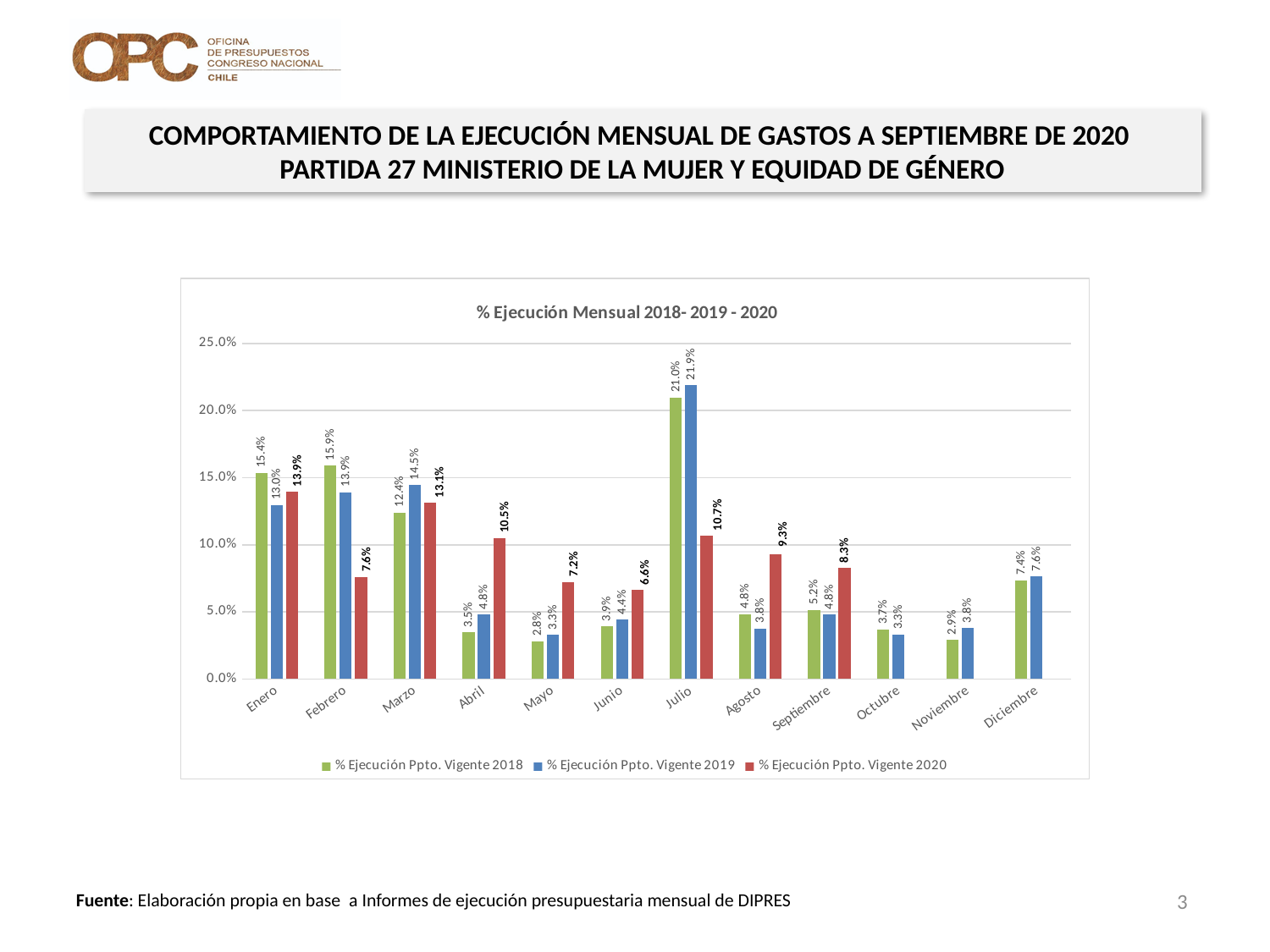
How many months are shown on the x axis? 12 What is the difference between the 2019 and 2018 values in Julio? 0.9% What is the value for % Ejecución Ppto. Vigente 2020 in Abril? 10.5% Which month has the highest value for % Ejecución Ppto. Vigente 2020? Enero What kind of chart is shown on the slide? Bar chart How many series does the legend list? 3 Is the value for % Ejecución Ppto. Vigente 2019 in Marzo greater or less than 10.0%? greater Which month has the lowest value for % Ejecución Ppto. Vigente 2018? Mayo What is the value for % Ejecución Ppto. Vigente 2018 in Febrero? 15.9% In Agosto, which series is larger: % Ejecución Ppto. Vigente 2020 or % Ejecución Ppto. Vigente 2018? % Ejecución Ppto. Vigente 2020 What is the title of the chart? % Ejecución Mensual 2018- 2019 - 2020 What is the value for % Ejecución Ppto. Vigente 2019 in Julio? 21.9%